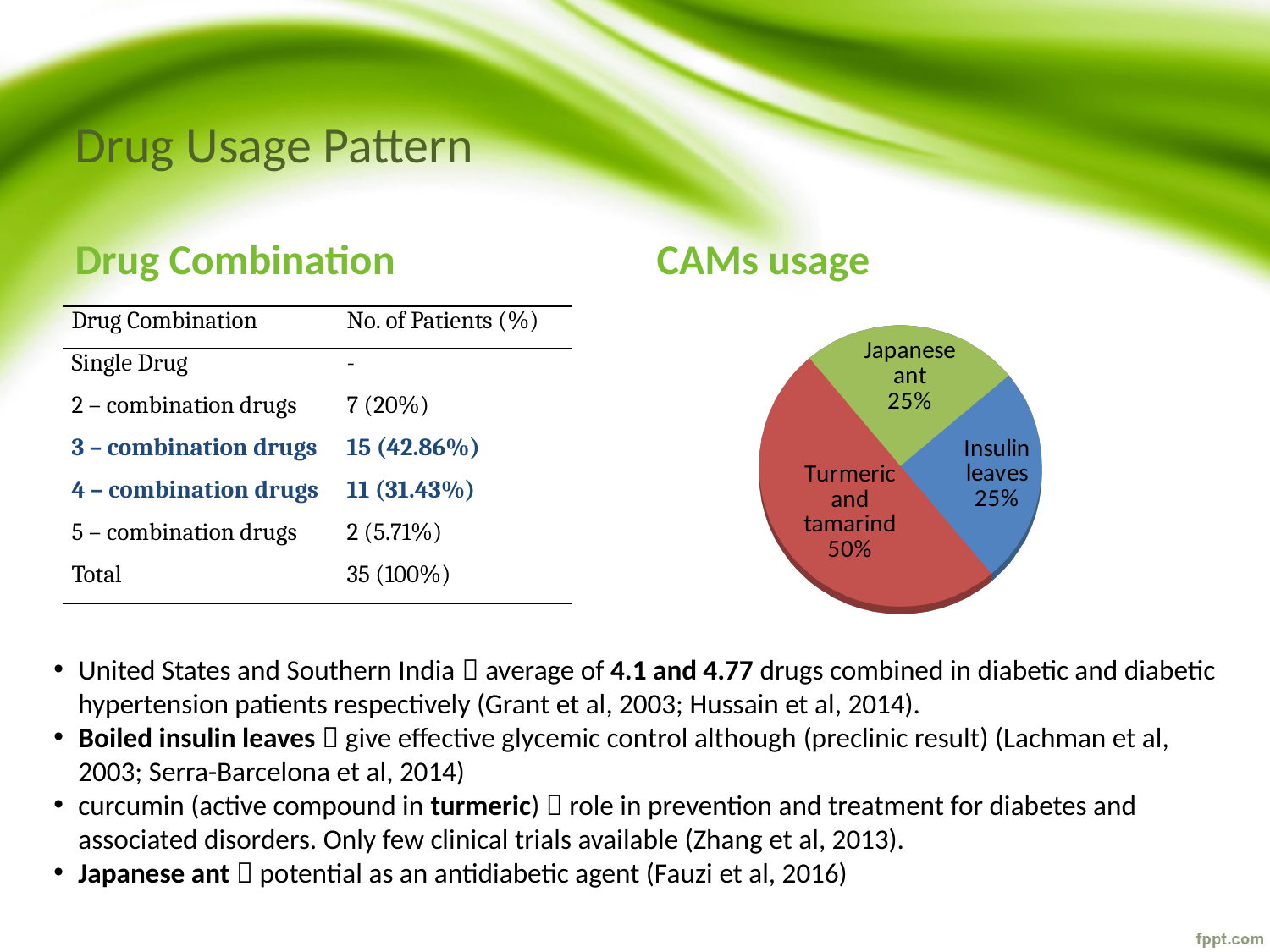
In the CAMs usage pie chart, what share does Insulin leaves have? 25% Which slice is the largest in the CAMs usage pie chart? Turmeric and tamarind In the CAMs usage pie chart, what is the combined share of Japanese ant and Insulin leaves? 50% How many slices does the CAMs usage pie chart have? 3 What colour is the Japanese ant slice in the CAMs usage pie chart? green In the CAMs usage pie chart, which is larger: Turmeric and tamarind or Japanese ant? Turmeric and tamarind In the CAMs usage pie chart, what is the difference between the Turmeric and tamarind share and the Insulin leaves share? 25% In the CAMs usage pie chart, what share does Turmeric and tamarind have? 50% In the CAMs usage pie chart, what share does Japanese ant have? 25% What colour is the Turmeric and tamarind slice in the CAMs usage pie chart? red What kind of chart is shown under the heading "CAMs usage"? pie chart